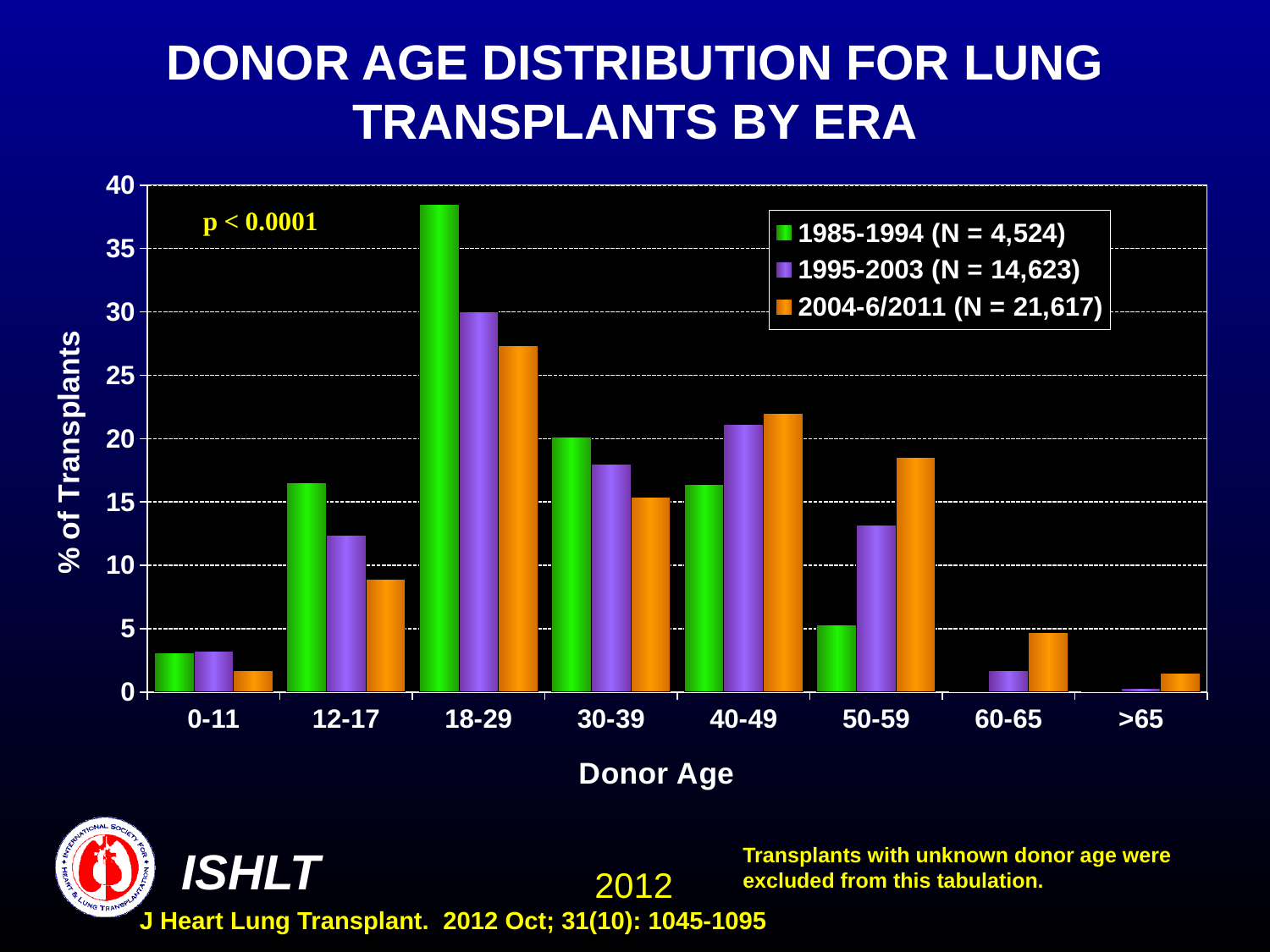
Is the value for the 2004-6/2011 series in the 50-59 donor age group greater or less than 15? greater In the 50-59 donor age group, which series has the larger value: 1985-1994 or 1995-2003? 1995-2003 Is the value for the 2004-6/2011 series in the 18-29 donor age group greater or less than 30? less What kind of chart is shown on the slide? bar chart In the 40-49 donor age group, which series has the larger value: 1985-1994 or 2004-6/2011? 2004-6/2011 Which donor age group has the highest value for the 2004-6/2011 series? 18-29 Which donor age group has the highest value for the 1985-1994 series? 18-29 Is the value for the 1985-1994 series in the 18-29 donor age group greater or less than 35? greater How many series does the legend list? 3 How many donor age categories are shown on the x axis? 8 What is the N shown in the legend for the 2004-6/2011 series? 21,617